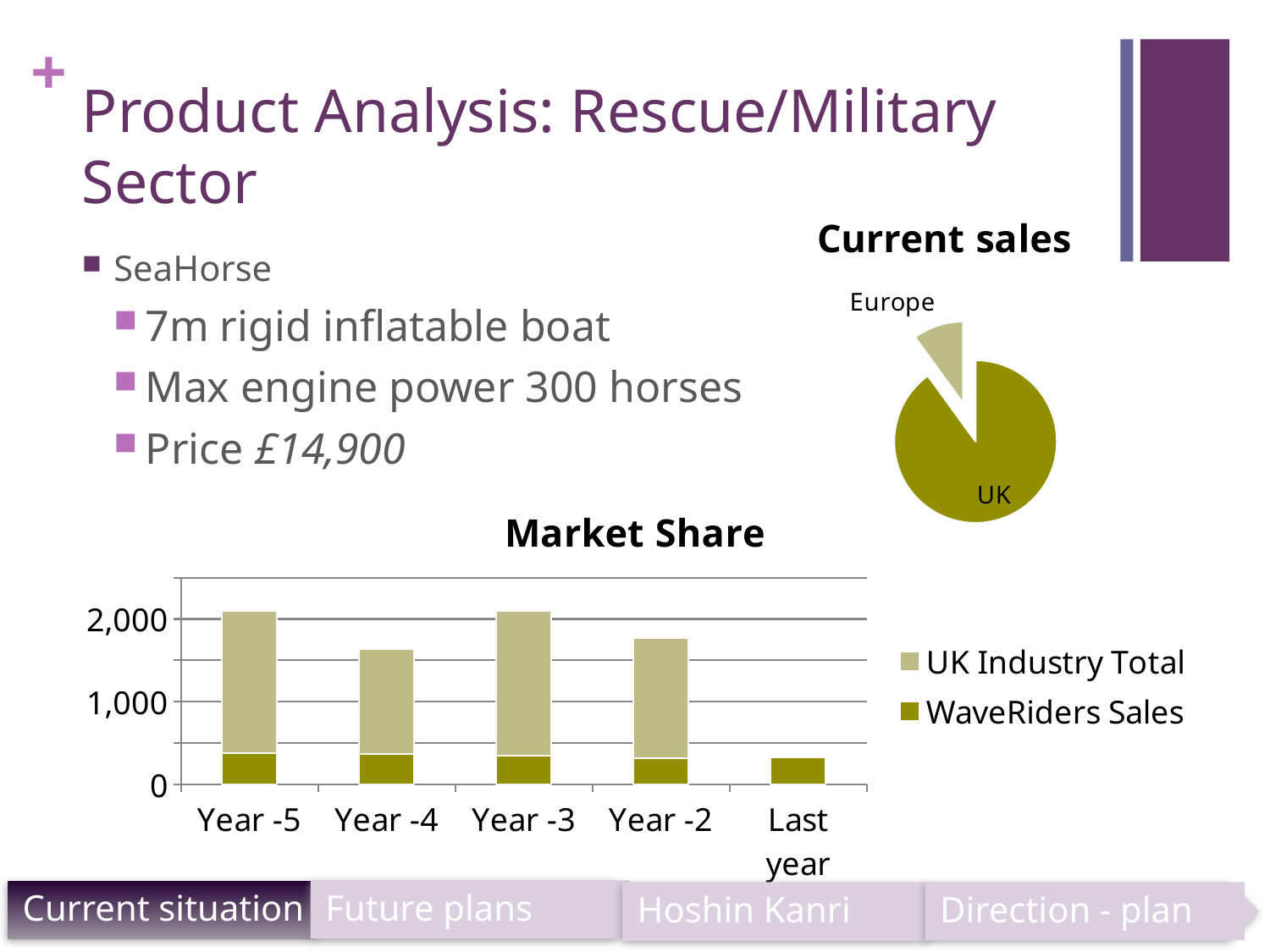
What kind of chart is the "Current sales" chart? pie chart In the "Market Share" chart, is the total stacked value for Year -4 greater or less than 2,000? less In the "Market Share" chart, which category shows only a WaveRiders Sales bar with no UK Industry Total segment? Last year How many slices does the "Current sales" pie chart have? 2 In the "Market Share" chart, is the WaveRiders Sales value for Last year greater or less than 1,000? less In the "Market Share" chart, is the total stacked value for Year -2 greater or less than 1,000? greater What kind of chart is the "Market Share" chart? bar chart How many categories are shown on the x axis of the "Market Share" chart? 5 In the "Market Share" chart, which has the taller stacked bar, Year -4 or Year -3? Year -3 In the "Market Share" chart, which series is shown in the darker olive colour at the bottom of each bar? WaveRiders Sales In the "Current sales" pie chart, which slice is larger, UK or Europe? UK How many series does the legend of the "Market Share" chart list? 2